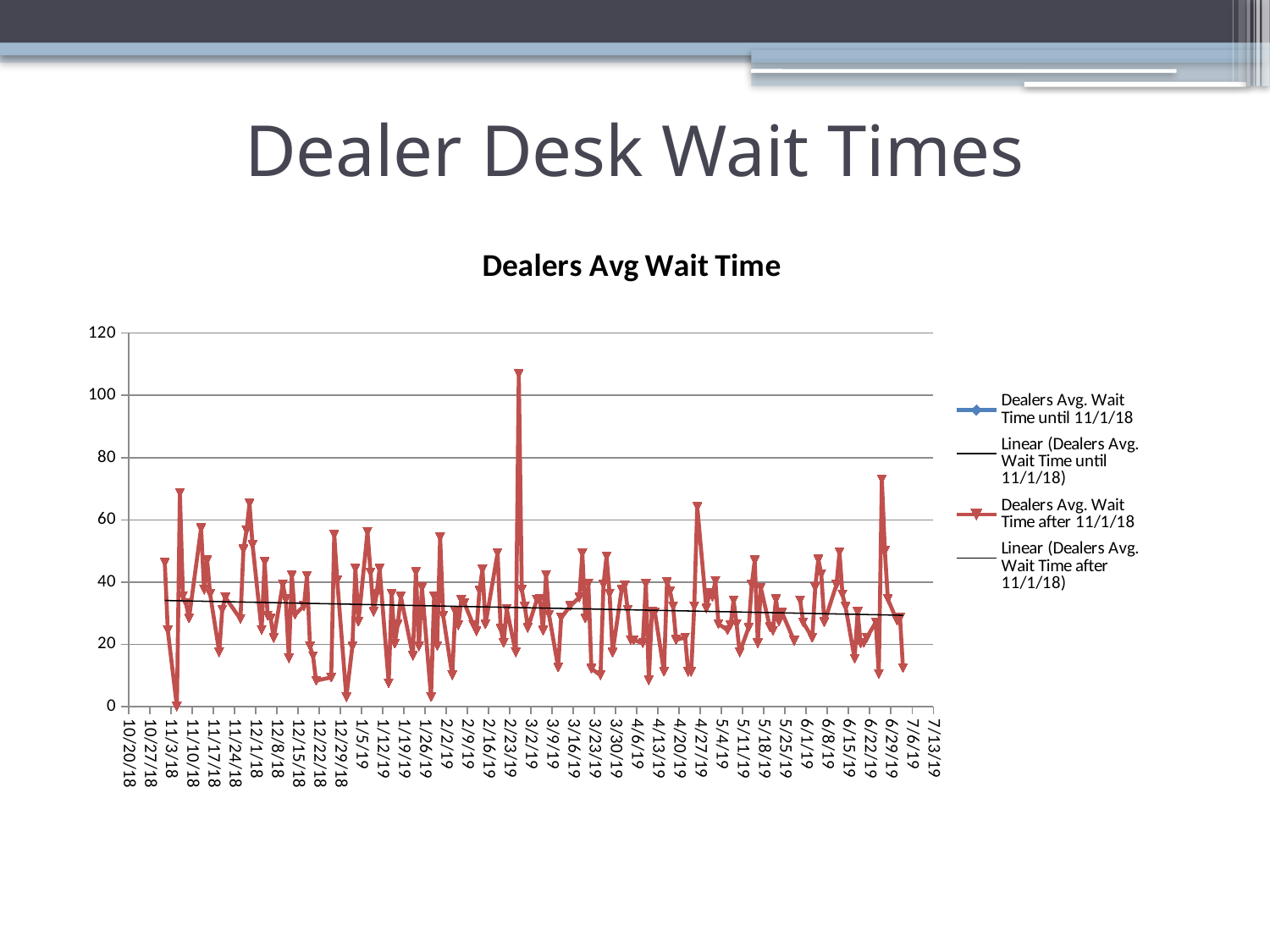
Is the highest plotted value for Dealers Avg. Wait Time after 11/1/18 greater or less than 100? greater What is the title of the chart? Dealers Avg Wait Time How many entries does the chart's legend list? 4 Does the linear trend line for Dealers Avg. Wait Time after 11/1/18 rise or fall from left to right? fall What is the highest value shown on the chart's vertical axis? 120 What kind of chart is shown on the slide? line chart Is the highest plotted value for Dealers Avg. Wait Time after 11/1/18 greater or less than 80? greater Is the lowest plotted value for Dealers Avg. Wait Time after 11/1/18 greater or less than 20? less